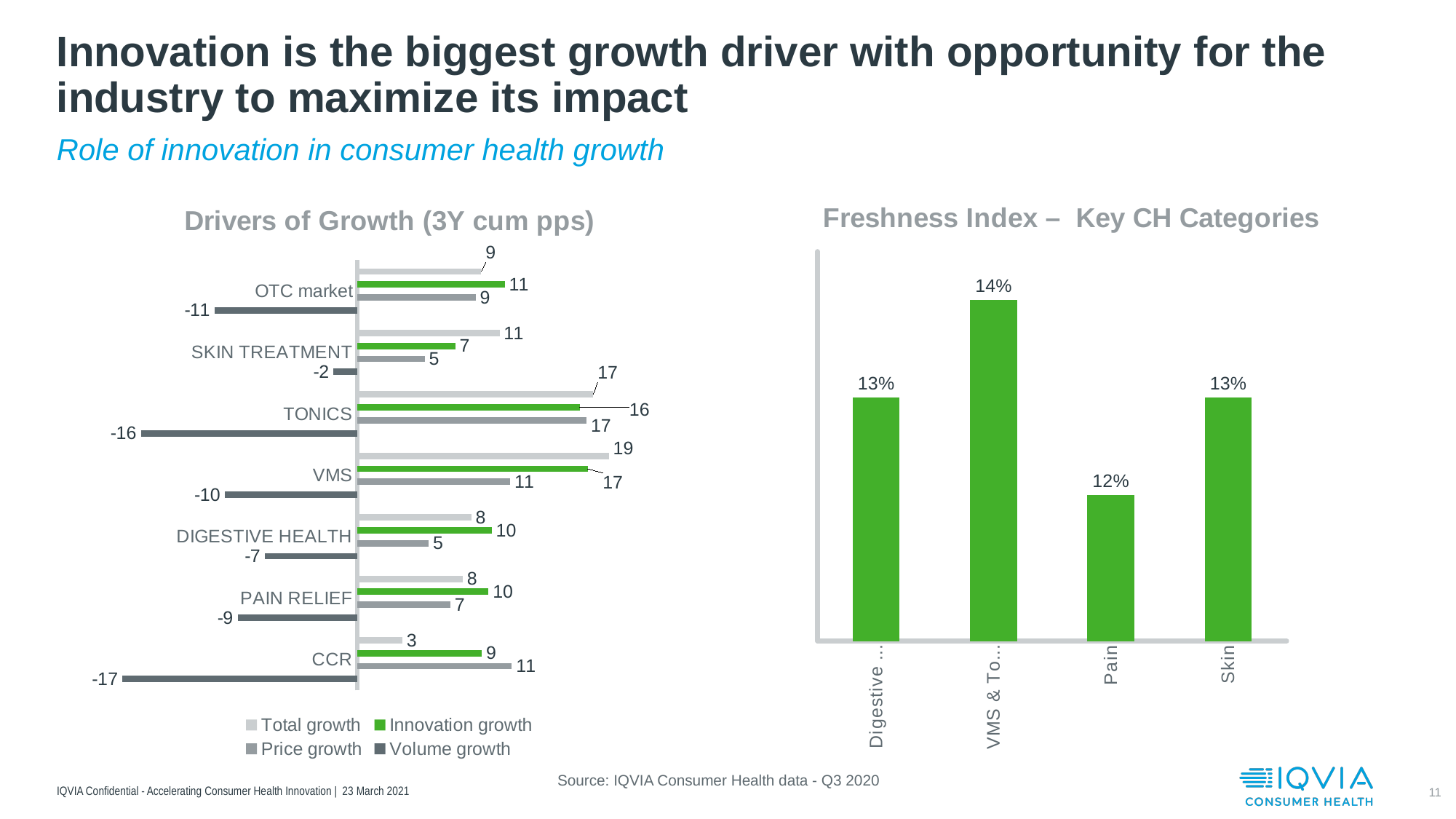
In the Freshness Index chart, what is the value for Skin? 13% In the Drivers of Growth chart, what is the Innovation growth value for VMS? 17 In the Drivers of Growth chart, which is larger for the OTC market: Innovation growth or Price growth? Innovation growth How many categories are shown in the Drivers of Growth chart? 7 In the Drivers of Growth chart, what is the Total growth value for TONICS? 17 In the Drivers of Growth chart, which category has the lowest Total growth? CCR In the Drivers of Growth chart, what is the Volume growth value for CCR? -17 In the Freshness Index chart, what is the value for Pain? 12% How many series does the legend of the Drivers of Growth chart list? 4 In the Drivers of Growth chart, what is the difference between Innovation growth and Price growth for SKIN TREATMENT? 2 In the Drivers of Growth chart, which category has the highest Total growth? VMS What type of chart is the Freshness Index – Key CH Categories chart? Bar chart